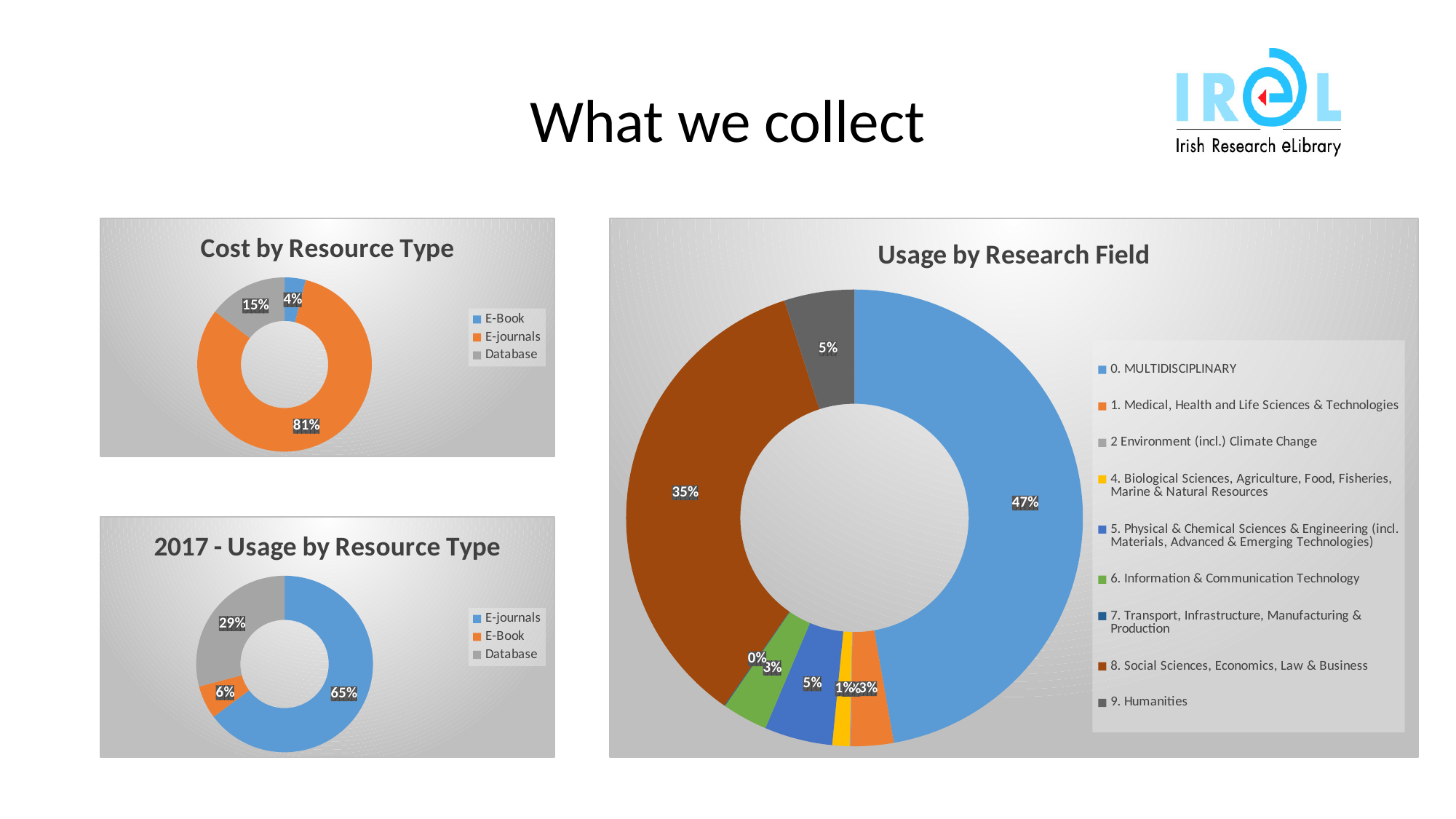
In the 'Usage by Research Field' chart, what percentage of usage is for 8. Social Sciences, Economics, Law & Business? 35% In the '2017 - Usage by Resource Type' chart, what percentage of usage is for E-journals? 65% In the 'Cost by Resource Type' chart, what percentage of cost is for E-journals? 81% How many research fields are listed in the legend of the 'Usage by Research Field' chart? 9 In the 'Usage by Research Field' chart, what is the difference in percentage points between 0. MULTIDISCIPLINARY and 8. Social Sciences, Economics, Law & Business? 12 percentage points In the '2017 - Usage by Resource Type' chart, which resource type has the largest share? E-journals In the 'Cost by Resource Type' chart, what percentage of cost is for Database? 15% In the 'Cost by Resource Type' chart, which resource type has the smallest share? E-Book In the 'Usage by Research Field' chart, what percentage of usage is for 0. MULTIDISCIPLINARY? 47% What kind of chart is the 'Usage by Research Field' chart? Donut (pie) chart In the 'Cost by Resource Type' chart, what is the difference in percentage points between E-journals and Database? 66 percentage points In the '2017 - Usage by Resource Type' chart, what percentage of usage is for Database? 29%